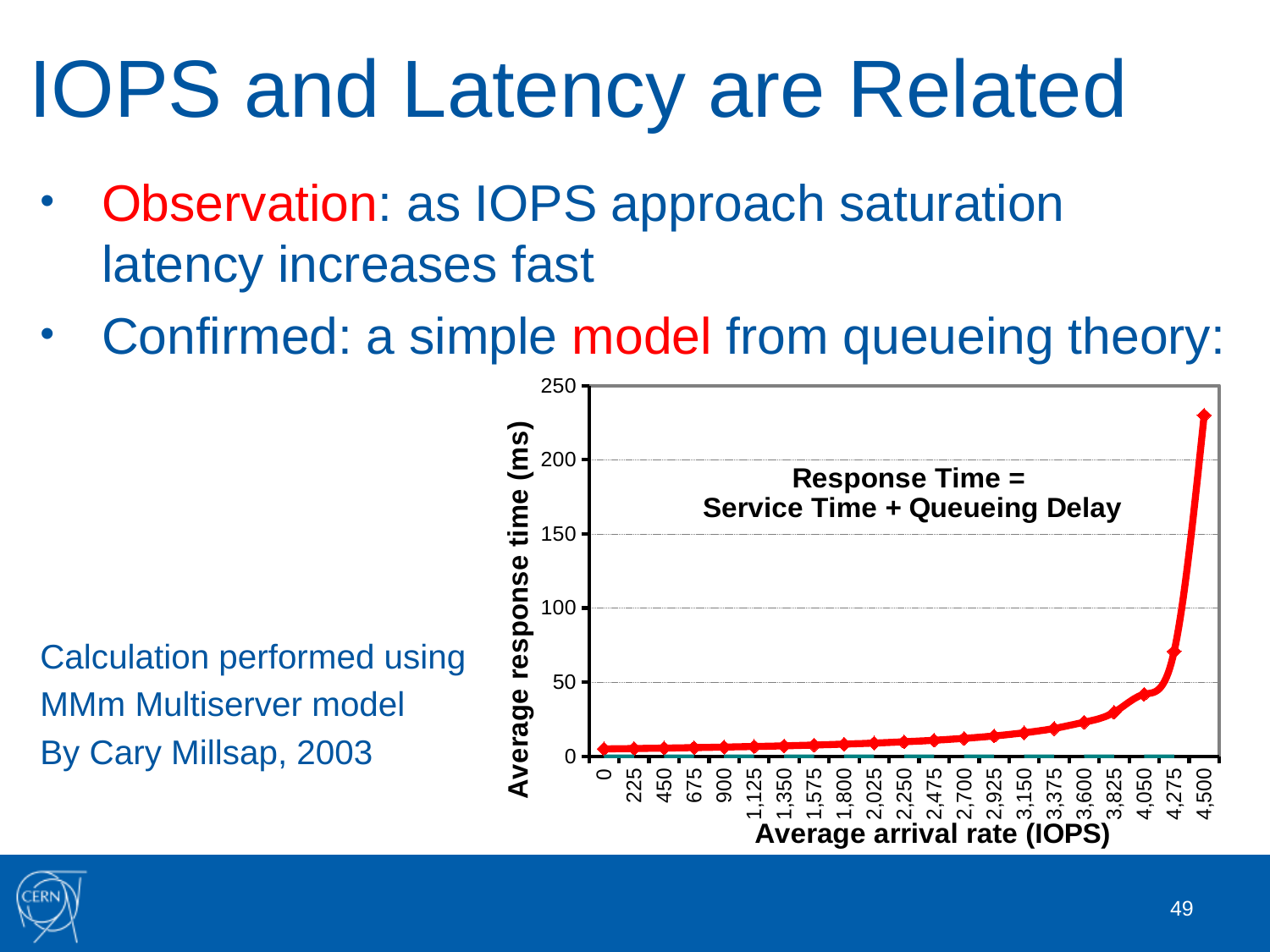
Is the average response time at 4,050 IOPS greater or less than 50 ms? less What is the label of the y axis of the chart? Average response time (ms) Is the average response time at 4,275 IOPS greater or less than 50 ms? greater Is the average response time at 2,250 IOPS greater or less than 50 ms? less At which average arrival rate (IOPS) is the average response time highest? 4,500 Does the average response time rise or fall as the average arrival rate increases along the x axis? rise Which has the larger average response time: 4,500 IOPS or 4,275 IOPS? 4,500 IOPS How many data points are plotted on the line, one per x-axis tick from 0 to 4,500? 21 Which has the larger average response time: 3,600 IOPS or 900 IOPS? 3,600 IOPS What kind of chart is shown on the slide? line chart What is the label of the x axis of the chart? Average arrival rate (IOPS)